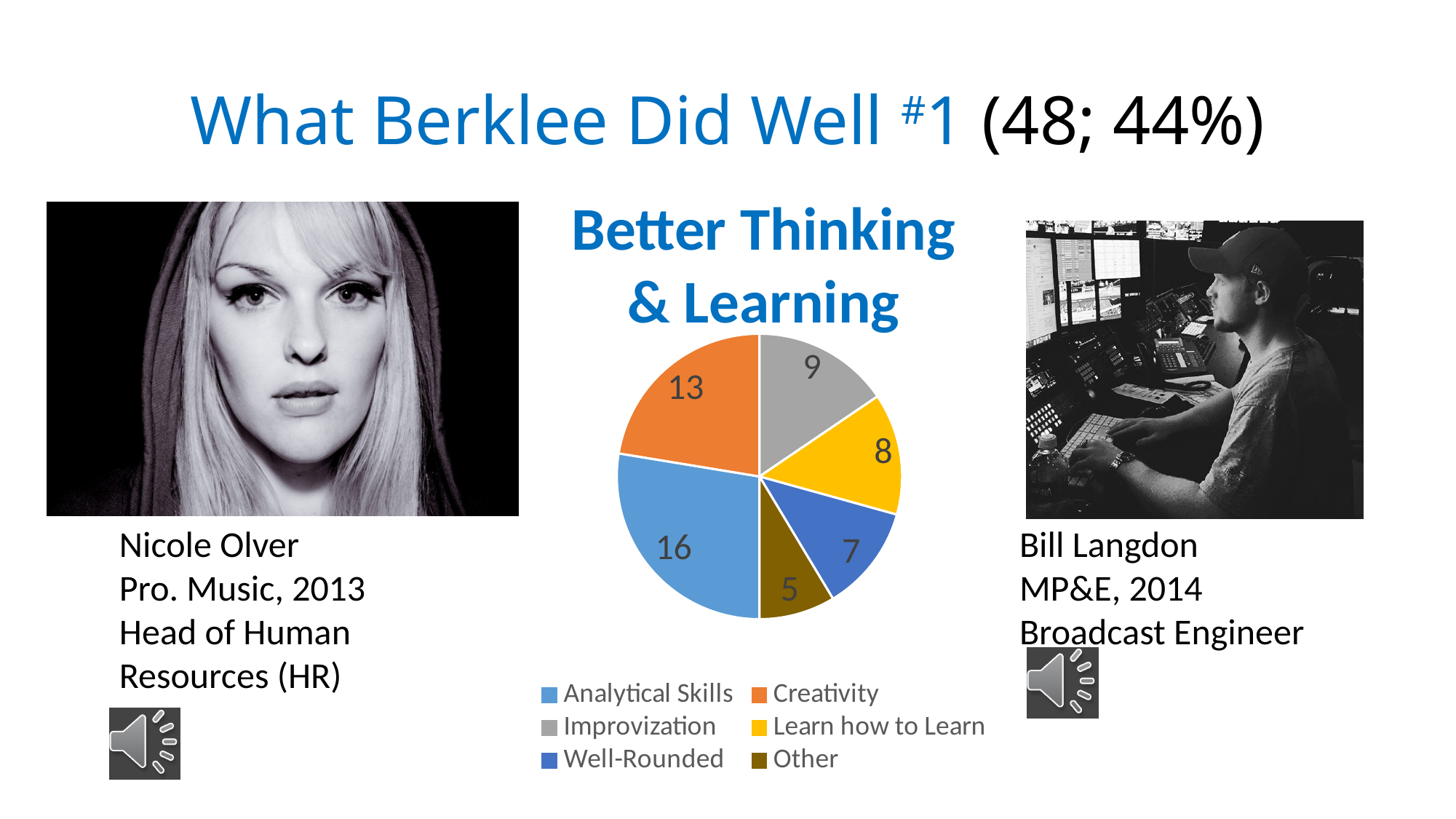
What is the difference between the values for Analytical Skills and Creativity? 3 What is the value for Analytical Skills in the pie chart? 16 What is the value for Creativity in the pie chart? 13 What is the value for Improvization in the pie chart? 9 What is the value for Well-Rounded in the pie chart? 7 What type of chart is shown on the slide? pie chart What is the value for Learn how to Learn in the pie chart? 8 Which category has the smallest slice in the pie chart? Other What is the title shown above the pie chart? Better Thinking & Learning Which category has the largest slice in the pie chart? Analytical Skills Which is larger, the value for Improvization or the value for Well-Rounded? Improvization How many categories does the pie chart legend list? 6